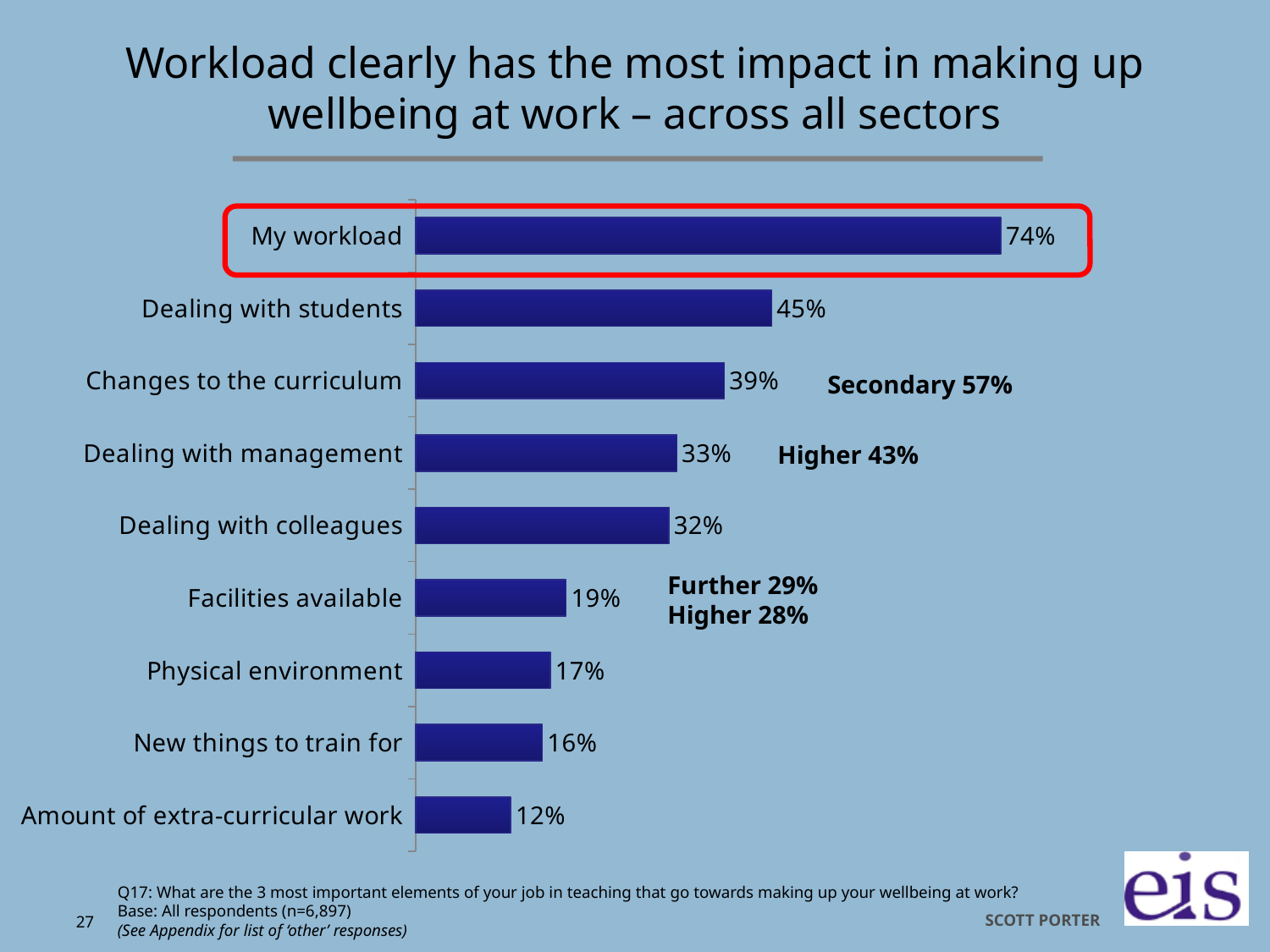
What kind of chart is shown on the slide? Bar chart Which category has the lowest value? Amount of extra-curricular work What is the value for 'Amount of extra-curricular work'? 12% What is the difference between 'My workload' and 'Dealing with students'? 29% How many categories are shown in the chart? 9 What percentage is shown for 'Facilities available'? 19% What is the value for 'Dealing with students'? 45% Which category has the highest value? My workload Which is larger, 'Physical environment' or 'New things to train for'? Physical environment What is the difference between 'Changes to the curriculum' and 'Dealing with management'? 6% What annotation is shown next to the 'Changes to the curriculum' bar? Secondary 57% What percentage is shown for 'My workload'? 74%